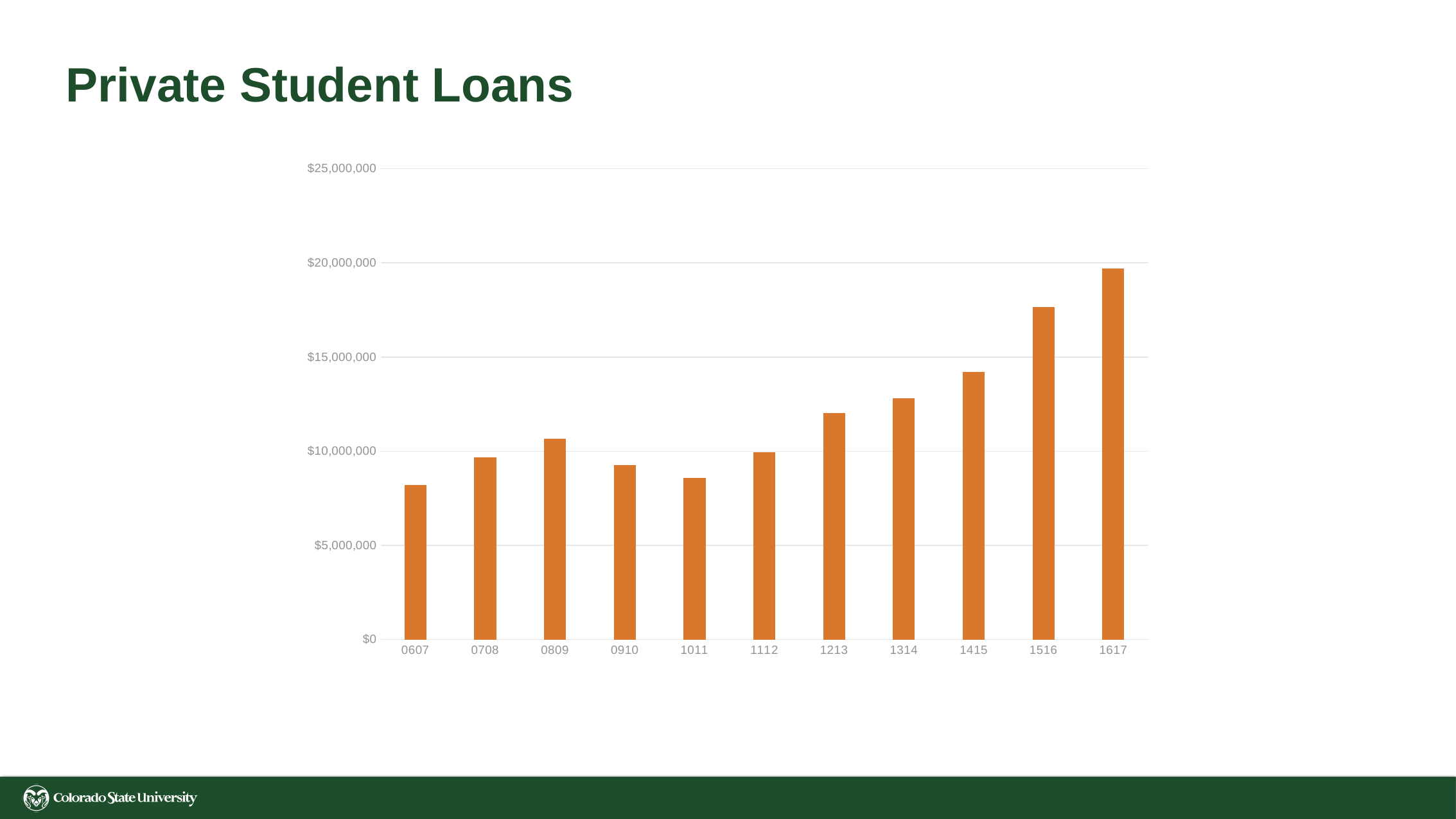
Is the value for 1617 greater or less than $15,000,000? greater Is the value for 1516 greater or less than $15,000,000? greater Which year has the highest private student loan amount? 1617 Is the value for 1213 greater or less than $10,000,000? greater How many academic years (bars) are shown on the x axis? 11 Which is larger, the value for 1516 or the value for 1415? 1516 Which is larger, the value for 0809 or the value for 0910? 0809 Do the values generally rise or fall from 1011 to 1617? Rise What kind of chart is shown on the slide? Bar chart What is the title of the slide containing the chart? Private Student Loans